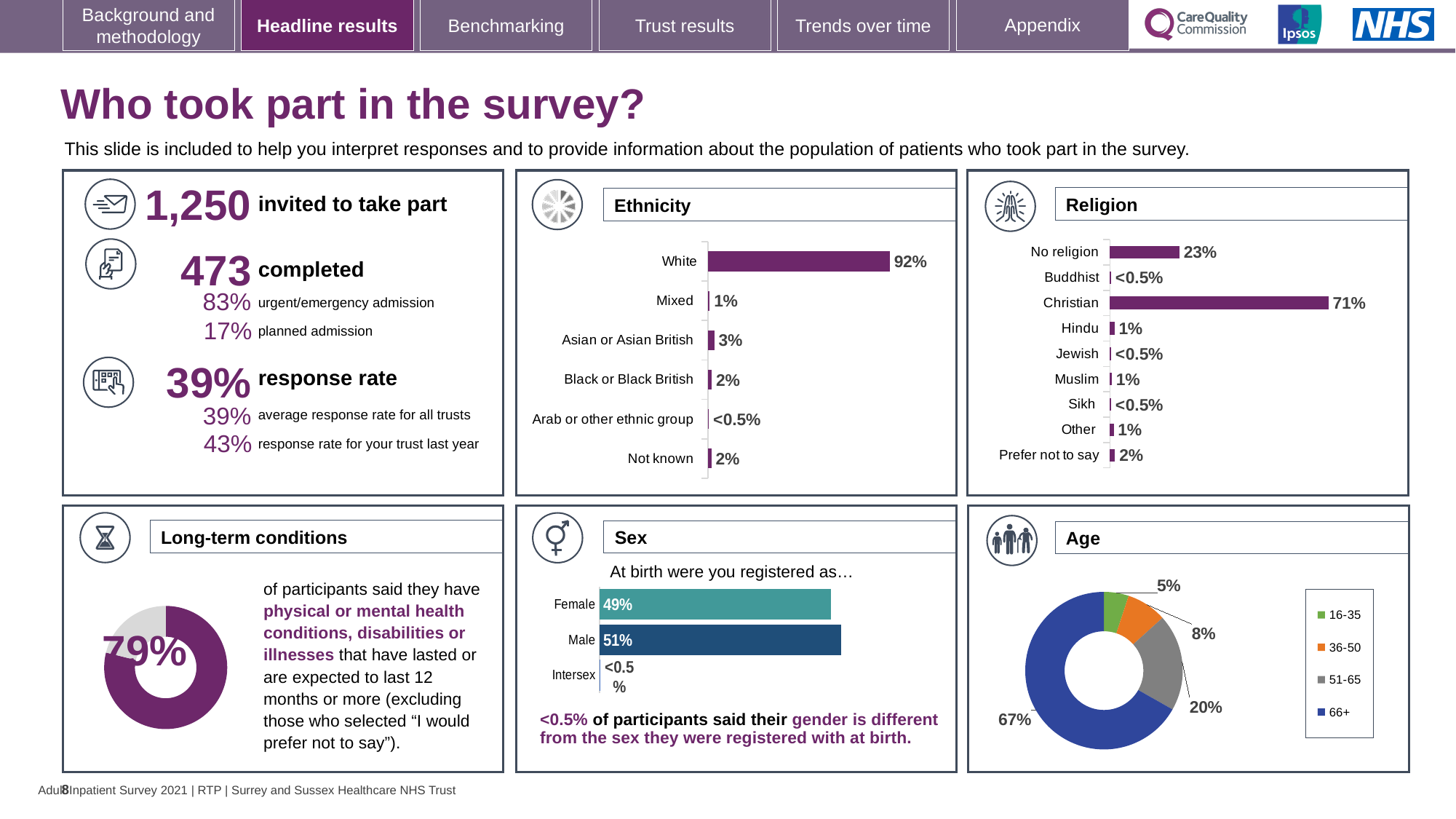
How many categories are shown in the Religion chart? 9 In the Religion chart, what is the difference between the Christian and No religion values? 48% In the Ethnicity chart, which category has the highest value? White In the Sex chart, what is the value for Female? 49% In the Ethnicity chart, what is the value for Asian or Asian British? 3% In the Ethnicity chart, what percentage of participants were White? 92% How many categories are shown in the Ethnicity chart? 6 In the Age chart, what share of participants were aged 66+? 67% What kind of chart is the Age chart? Doughnut chart How many series does the legend of the Age chart list? 4 In the Religion chart, what percentage of participants were Christian? 71% In the Sex chart, which is larger, the value for Female or Male? Male